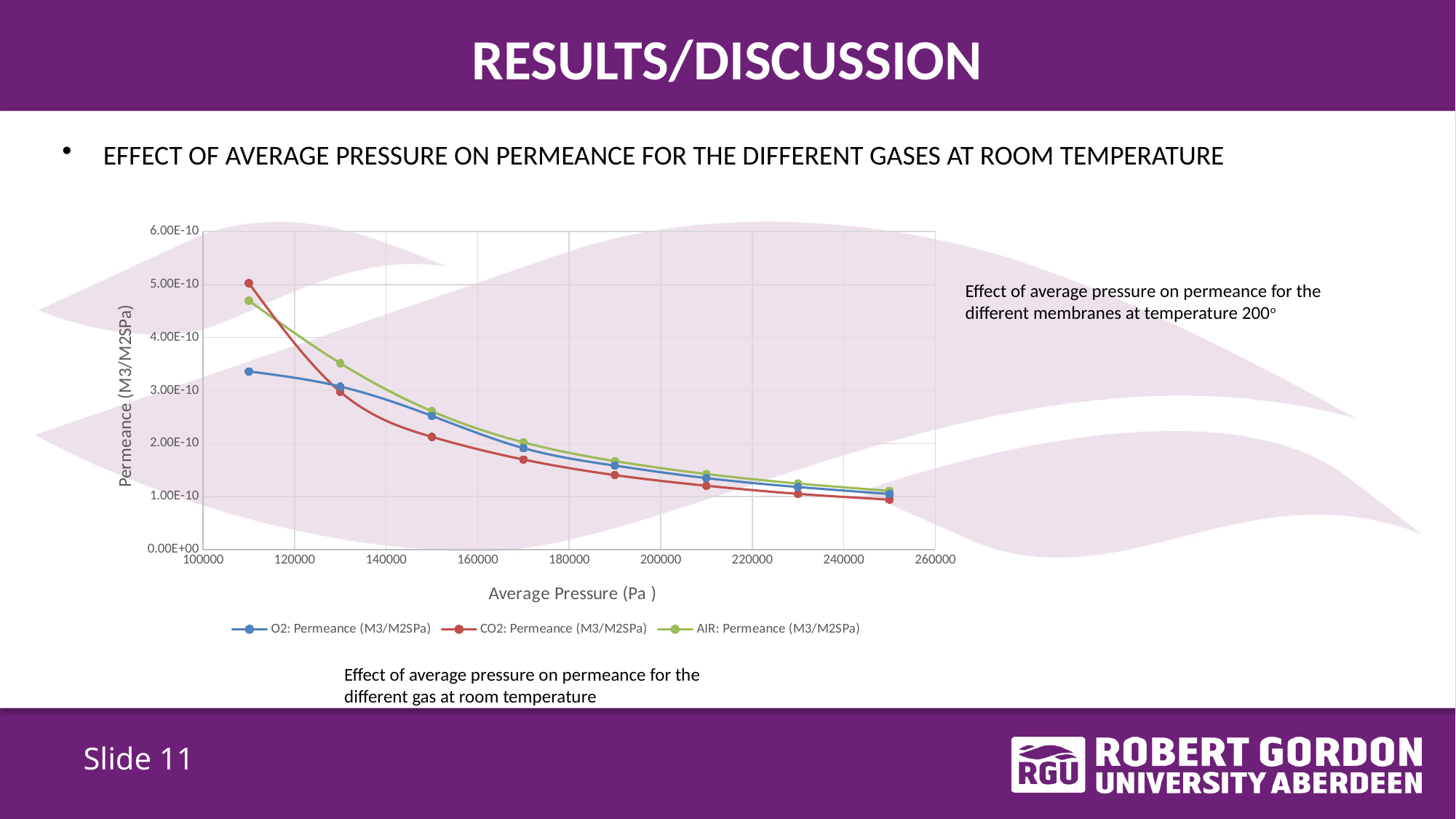
What kind of chart is shown on the slide? Line chart How many data points are plotted for the O2 series? 8 Do the permeance values rise or fall as average pressure increases? Fall What is the title of the x axis of the chart? Average Pressure (Pa ) Is the O2 permeance at 110000 Pa greater or less than 3.00E-10? greater Which series has the lowest permeance at an average pressure of 110000 Pa? O2: Permeance (M3/M2SPa) At 150000 Pa, which is larger: the AIR permeance or the CO2 permeance? AIR permeance How many series does the legend list? 3 Is the AIR permeance at 110000 Pa greater or less than 4.00E-10? greater Is the CO2 permeance at 150000 Pa greater or less than 3.00E-10? less At 170000 Pa, which is larger: the O2 permeance or the CO2 permeance? O2 permeance Which series has the highest permeance at an average pressure of 110000 Pa? CO2: Permeance (M3/M2SPa)